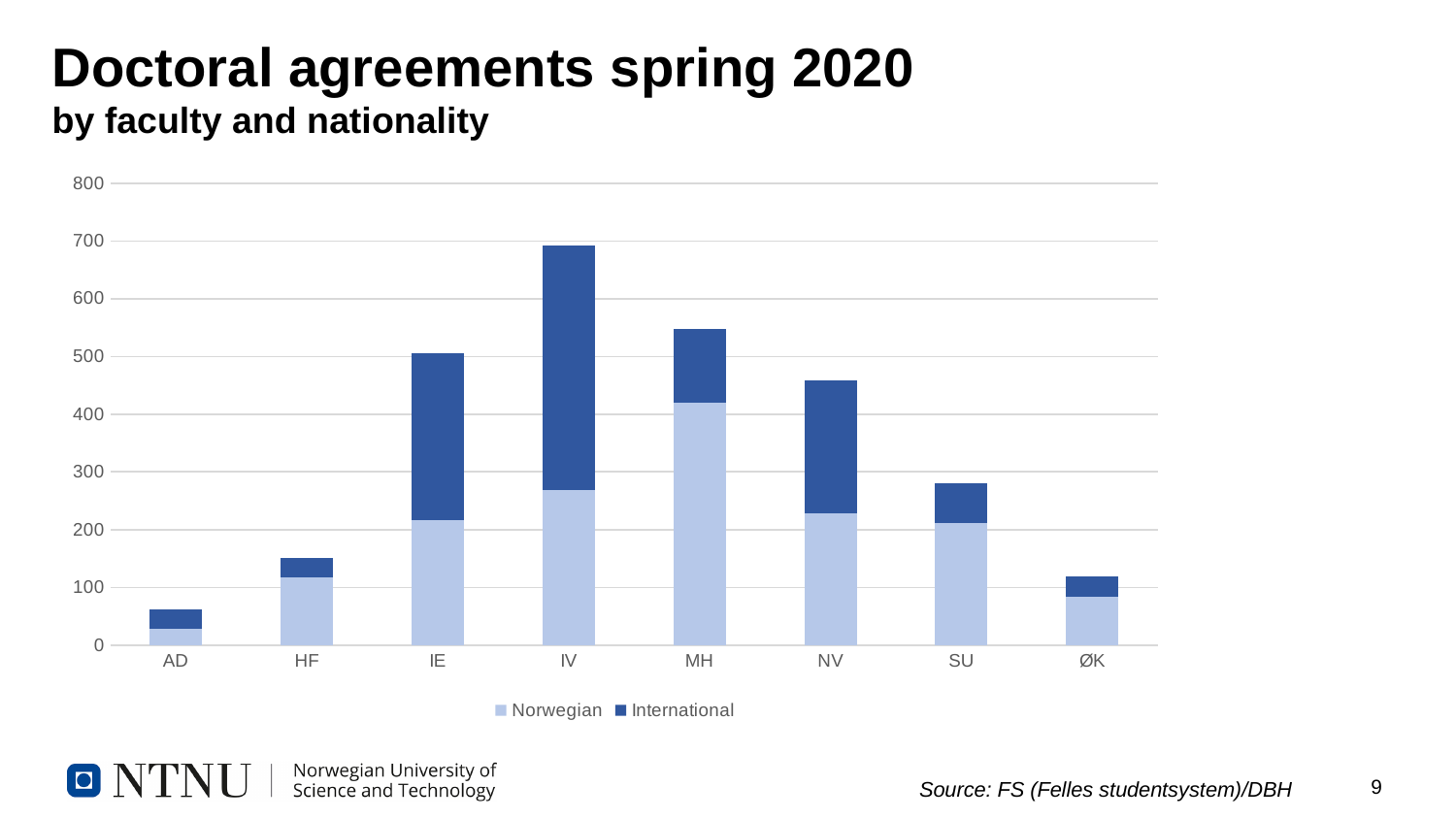
What kind of chart is shown on the slide? Stacked bar chart How many series does the legend list? 2 Which faculty has the larger total bar, MH or NV? MH Is the total bar height for AD greater or less than 100? less What are the two series named in the legend? Norwegian and International Which faculty has the shortest bar (fewest doctoral agreements in total)? AD Is the total bar height for IV greater or less than 600? greater How many faculties are shown on the x axis? 8 Is the total bar height for NV greater or less than 400? greater Which faculty has the largest Norwegian segment? MH Which faculty has the tallest bar (most doctoral agreements in total)? IV